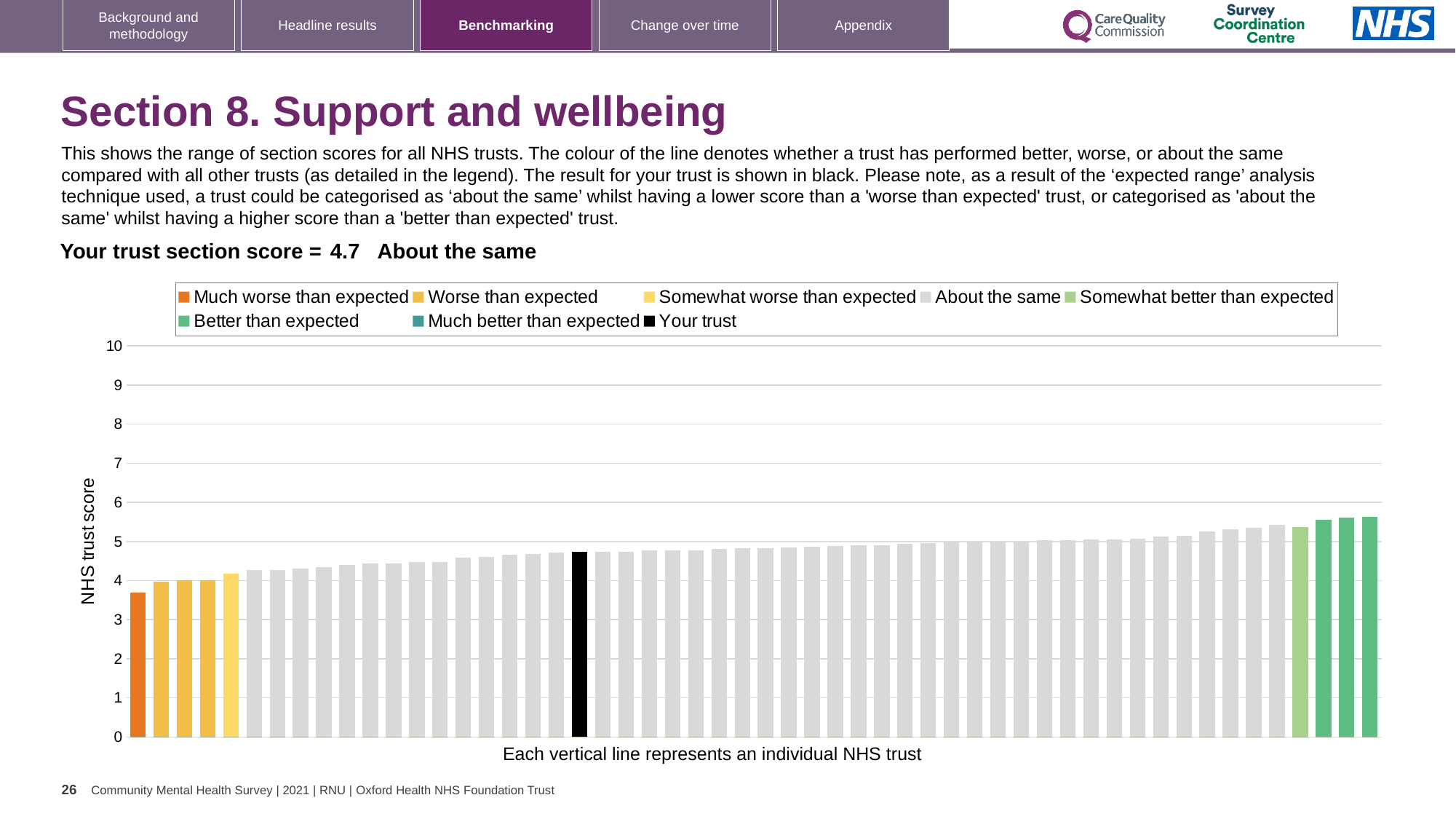
How many bars are coloured as 'Much worse than expected'? 1 Do the bar values rise or fall from left to right along the x axis? rise Is the value of the highest bar on the chart greater or less than 5? greater How many entries does the chart legend list? 8 Is the value for your trust (the black bar) greater or less than 5? less What colour is used for the 'Your trust' bar in the chart? black What is the section score for your trust shown on the slide? 4.7 Which legend category does the lowest bar on the chart belong to? Much worse than expected What kind of chart is shown on the slide? bar chart What is the label on the vertical axis of the chart? NHS trust score Is the value of the lowest bar (the orange bar) greater or less than 4? less